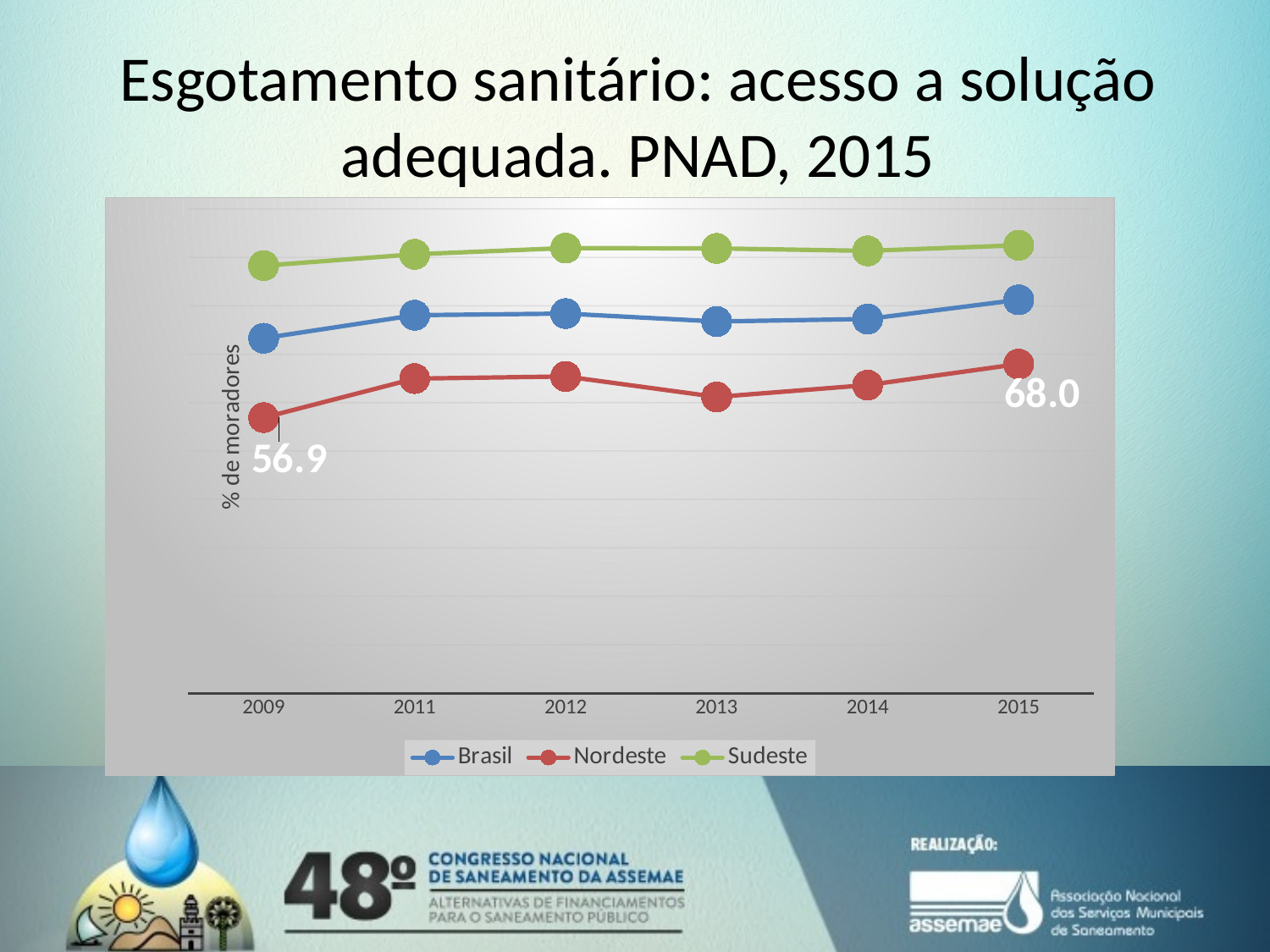
What is the label on the y axis? % de moradores By how much did the Nordeste value increase from 2009 to 2015? 11.1 Which series has the lowest value in 2009? Nordeste Which series has the highest value in 2015? Sudeste What is the value for Nordeste in 2015? 68.0 How many years are plotted along the x axis? 6 In which year is the Nordeste series at its lowest? 2009 What is the value for Nordeste in 2009? 56.9 What kind of chart is shown on the slide? line chart Does the Nordeste series rise or fall overall from 2009 to 2015? rise In 2012, which is larger, the value for Brasil or the value for Nordeste? Brasil How many series does the legend list? 3